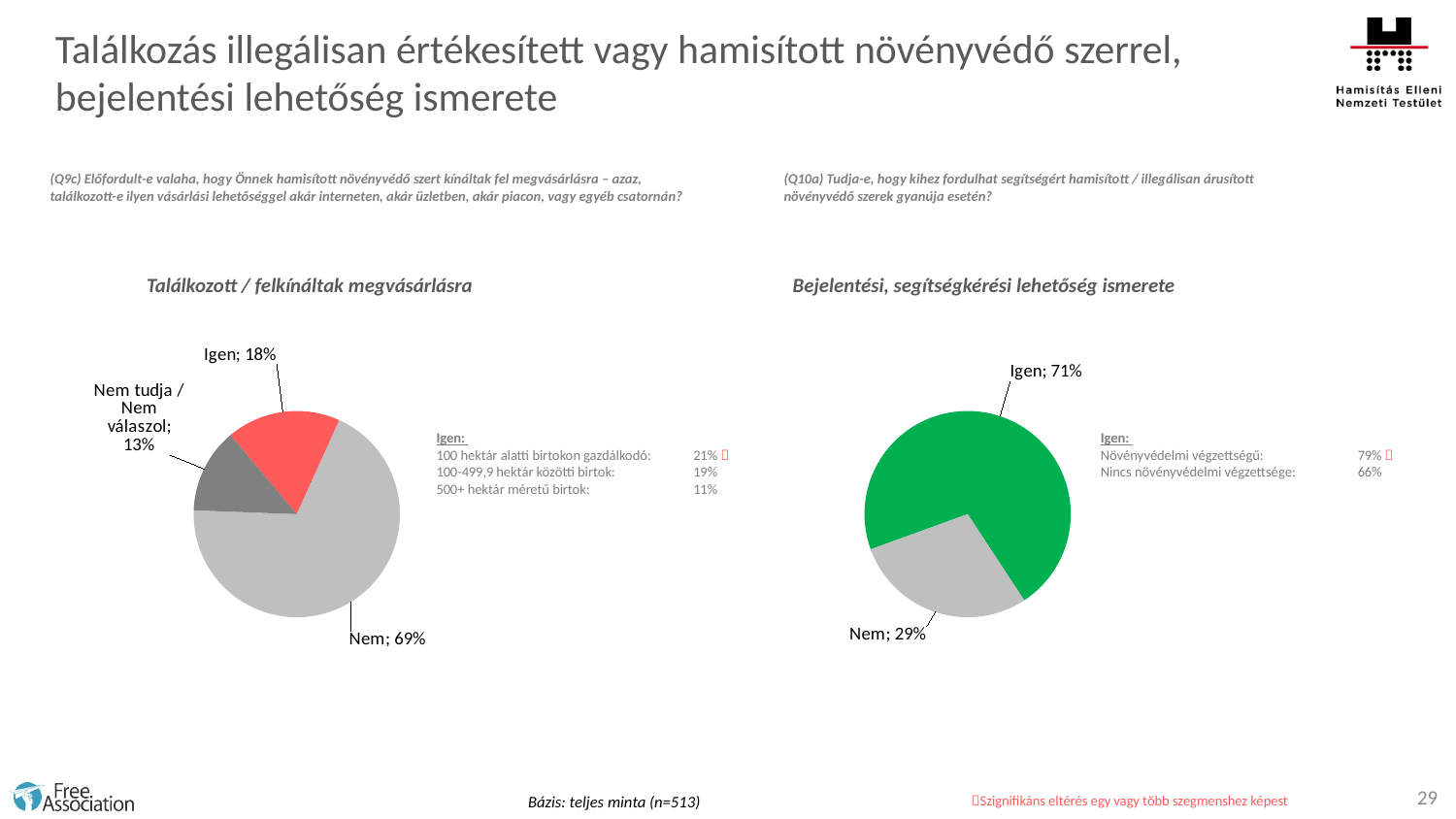
In the left chart (Találkozott / felkínáltak megvásárlásra), which category has the smallest slice? Nem tudja / Nem válaszol In the right chart (Bejelentési, segítségkérési lehetőség ismerete), what share of respondents answered Nem? 29% In the left chart (Találkozott / felkínáltak megvásárlásra), what is the difference in percentage points between Nem and Igen? 51 How many slices does the left pie chart (Találkozott / felkínáltak megvásárlásra) have? 3 In the right chart (Bejelentési, segítségkérési lehetőség ismerete), what share of respondents answered Igen? 71% In the left chart (Találkozott / felkínáltak megvásárlásra), what share is labelled Nem tudja / Nem válaszol? 13% In the right chart (Bejelentési, segítségkérési lehetőség ismerete), what is the difference in percentage points between Igen and Nem? 42 In the right chart (Bejelentési, segítségkérési lehetőség ismerete), which is larger, Igen or Nem? Igen In the left chart (Találkozott / felkínáltak megvásárlásra), what share of respondents answered Igen? 18% What type of chart is used on the right side of the slide (Bejelentési, segítségkérési lehetőség ismerete)? Pie chart In the left chart (Találkozott / felkínáltak megvásárlásra), what share of respondents answered Nem? 69% In the left chart (Találkozott / felkínáltak megvásárlásra), which category has the largest slice? Nem